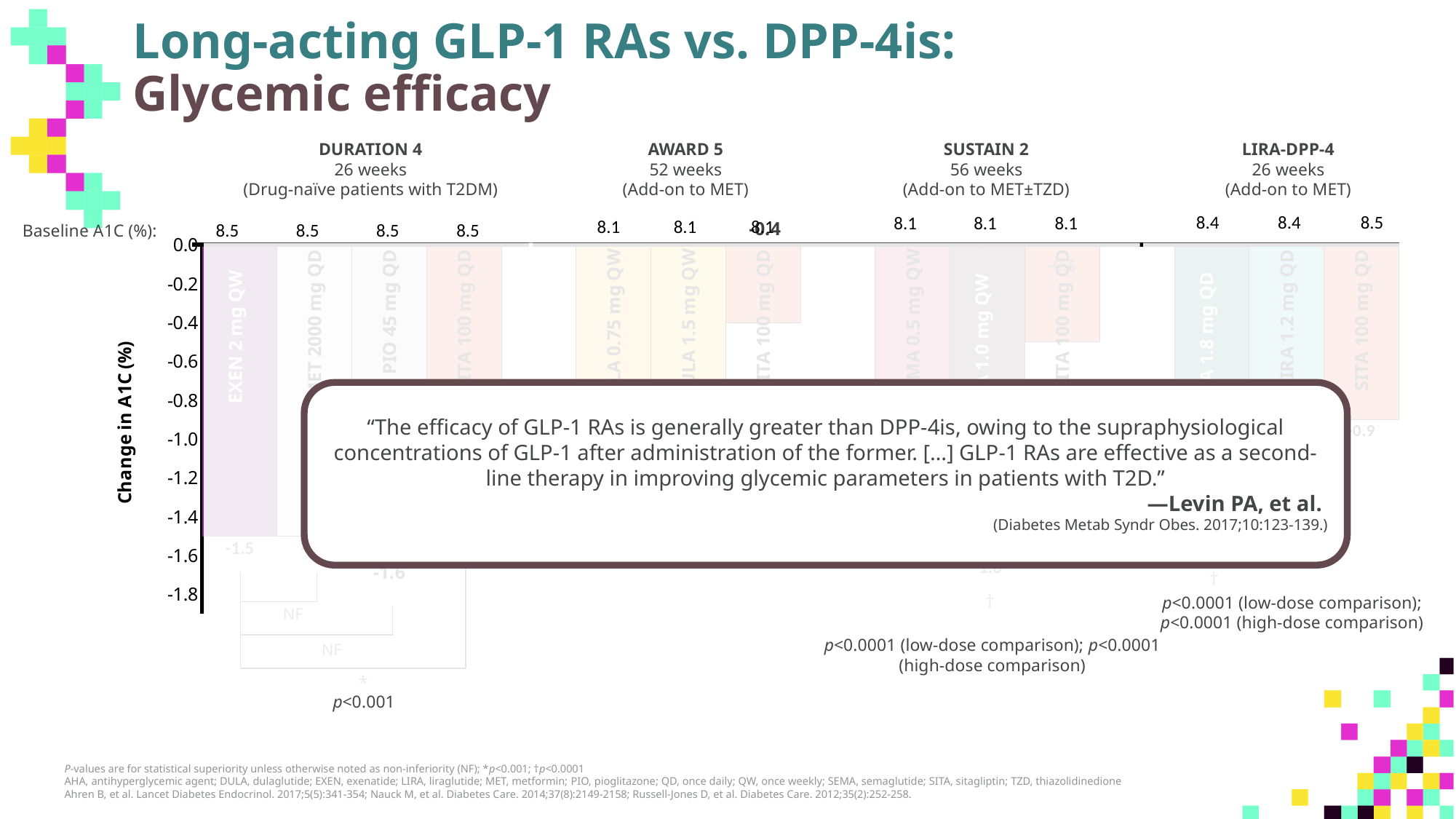
How many trials are shown across the top of the chart? 4 Which shows a larger reduction in A1C: EXEN 2 mg QW in DURATION 4 or SITA 100 mg QD in AWARD 5? EXEN 2 mg QW What is the baseline A1C (%) for the arms in the SUSTAIN 2 trial? 8.1 What is the change in A1C (%) for SITA 100 mg QD in the AWARD 5 trial? -0.4 How many treatment bars are shown for the DURATION 4 trial? 4 How many treatment bars are shown for the AWARD 5 trial? 3 What kind of chart is shown on the slide? bar chart What is the label of the vertical axis of the chart? Change in A1C (%) What is the change in A1C (%) for EXEN 2 mg QW in DURATION 4? -1.5 Which trial had a duration of 52 weeks? AWARD 5 What is the baseline A1C (%) for the EXEN 2 mg QW arm in DURATION 4? 8.5 What is the baseline A1C (%) for the SITA 100 mg QD arm in the LIRA-DPP-4 trial? 8.5